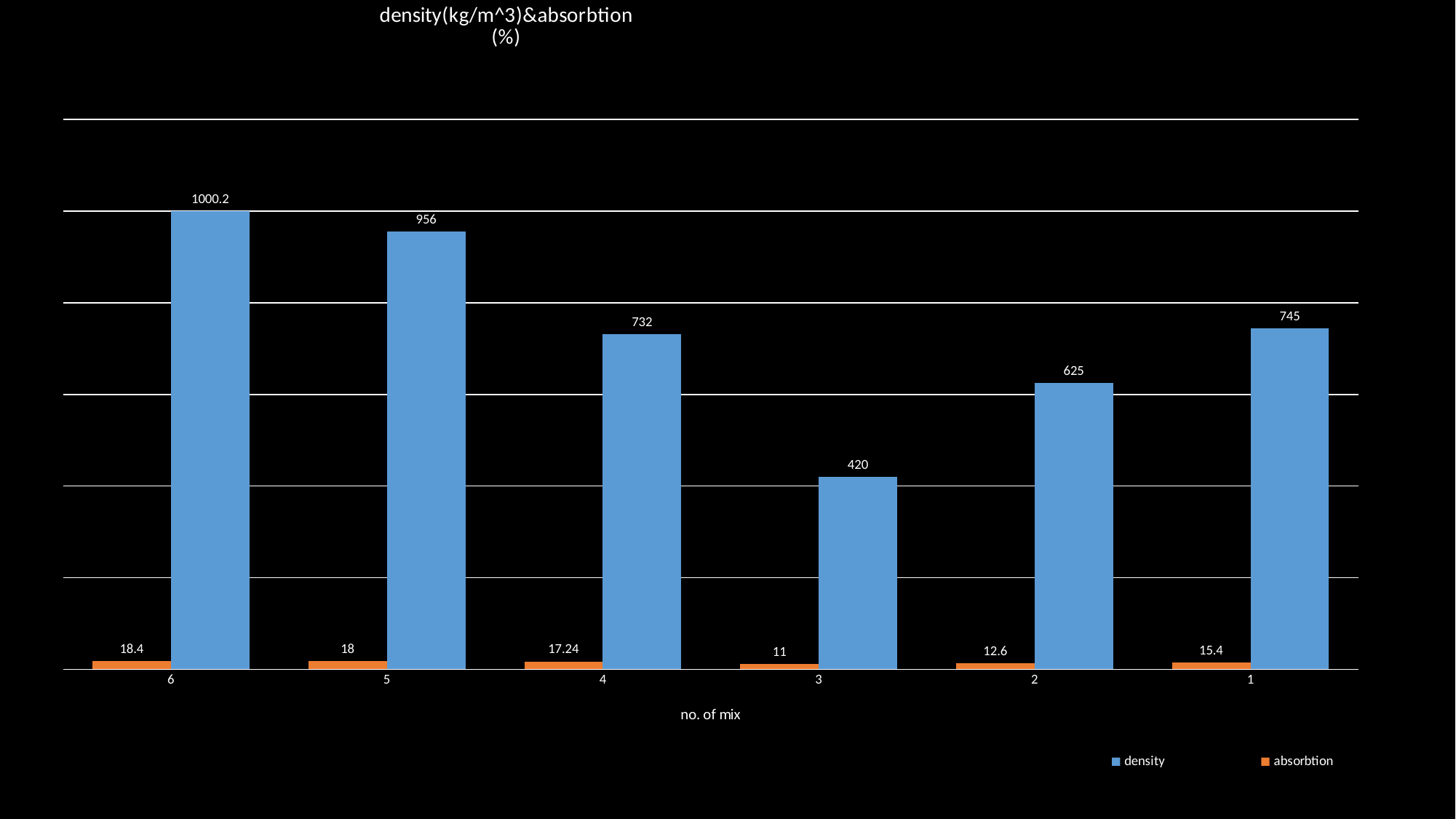
What is the density value for mix 3? 420 Which mix has the lowest absorbtion? 3 How many series does the legend list? 2 What is the x-axis title of the chart? no. of mix What is the density value for mix 6? 1000.2 What is the difference between the density of mix 5 and the density of mix 4? 224 Which mix has the highest density? 6 What is the absorbtion value for mix 4? 17.24 How many mixes are shown on the x axis? 6 Which has a higher density, mix 2 or mix 1? 1 What is the difference between the absorbtion of mix 6 and the absorbtion of mix 2? 5.8 What kind of chart is shown on the slide? bar chart